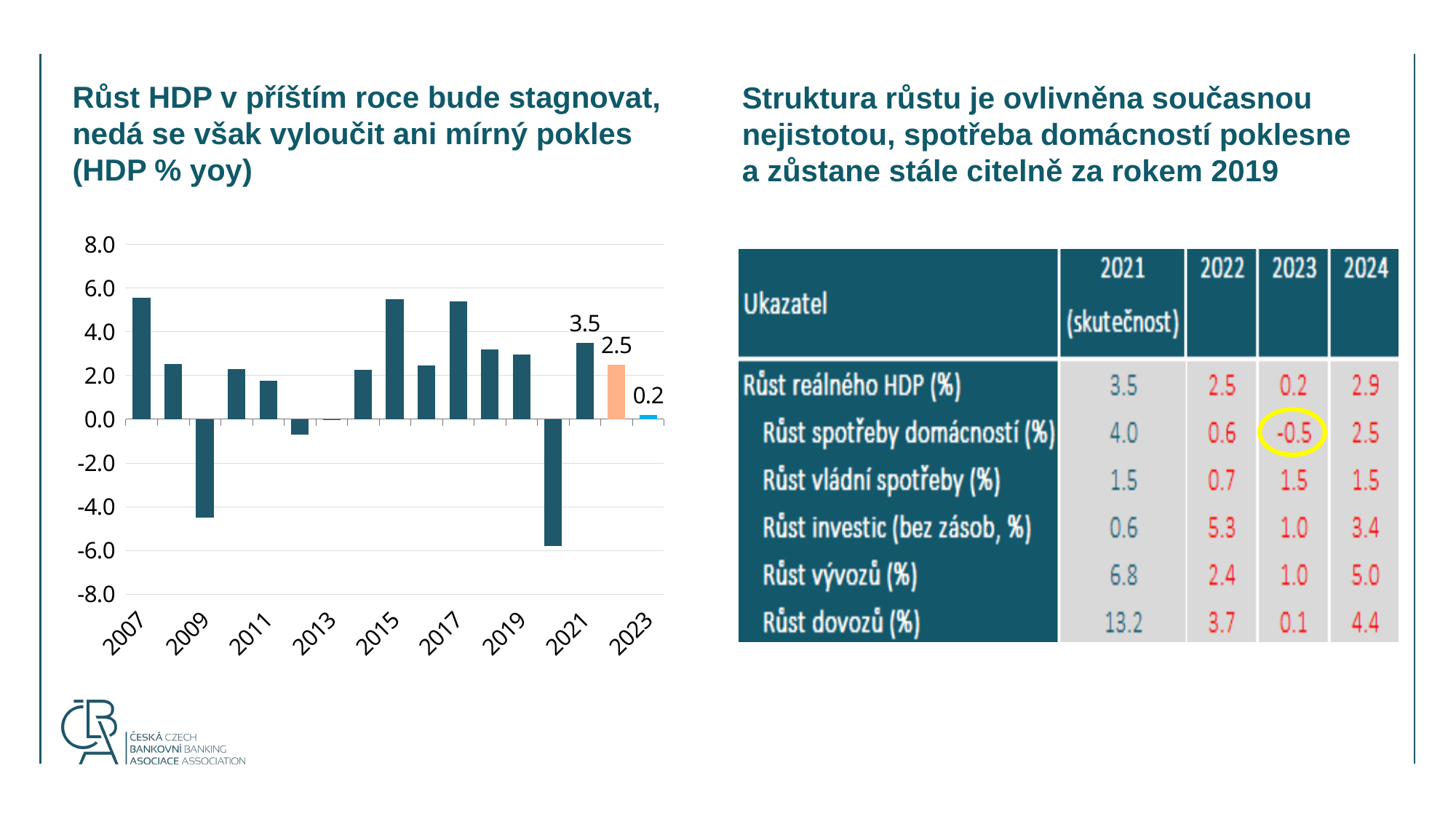
In the bar chart, which is larger, the value for 2021 or the value for 2023? 2021 In the bar chart, what is the value for 2023? 0.2 How many years (bars) are plotted in the bar chart? 17 In the bar chart, which year has the lowest value? 2020 In the bar chart, is the value for 2007 greater or less than 4.0? greater What type of chart is shown on the left of the slide? bar chart In the bar chart, is the value for 2009 greater or less than -4.0? less In the bar chart, what is the difference between the values for 2021 and 2022? 1.0 In the bar chart, do the values rise or fall from 2021 to 2023? fall In the bar chart, what is the value for 2022? 2.5 In the bar chart, what is the value for 2021? 3.5 In the bar chart, what is the difference between the values for 2022 and 2023? 2.3